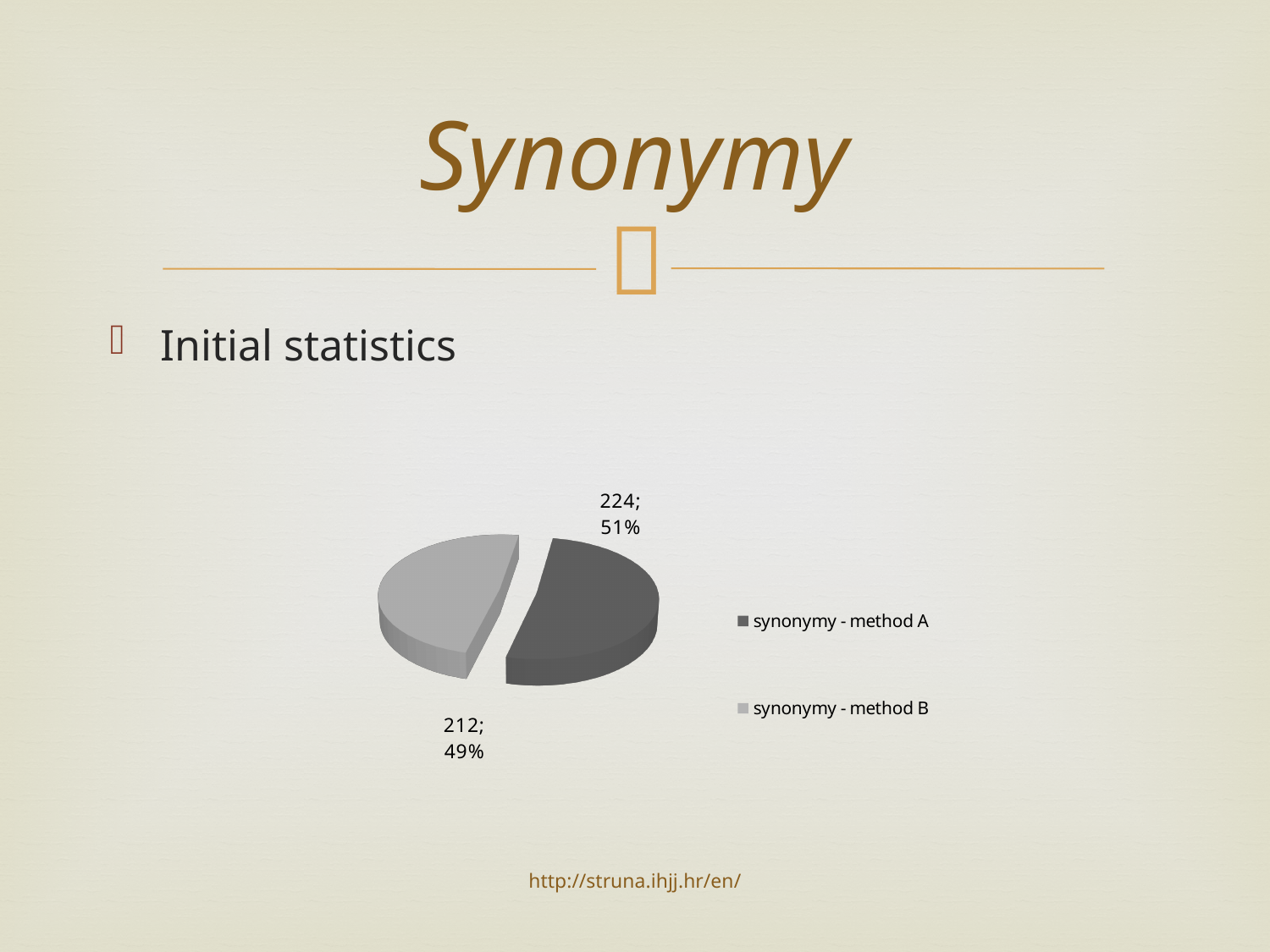
Which legend entry is shown in the darker grey colour? synonymy - method A Which slice is the smallest? synonymy - method B What is the total of the two slice values? 436 What kind of chart is shown on the slide? pie chart What is the value for synonymy - method B? 212 How many entries does the legend list? 2 How many slices does the pie chart have? 2 What is the value for synonymy - method A? 224 What share of the pie does synonymy - method A take? 51% What share of the pie does synonymy - method B take? 49% What is the difference between the values for synonymy - method A and synonymy - method B? 12 Which slice is the largest? synonymy - method A